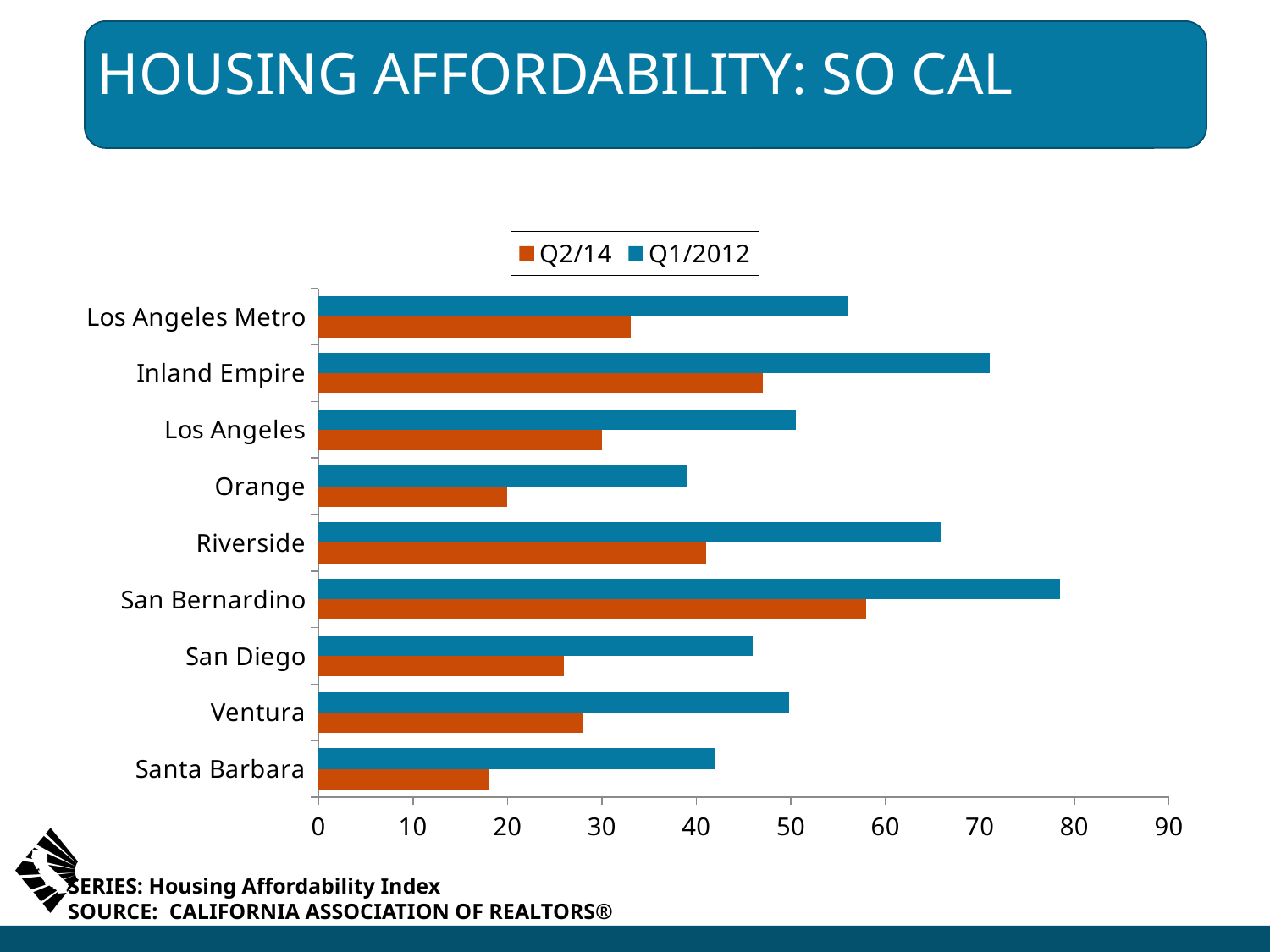
Is the Q1/2012 value for San Bernardino greater or less than 70? greater Is the Q2/14 value for Orange greater or less than 30? less Which region has the highest Q2/14 value? San Bernardino How many regions are plotted on the chart? 9 How many series does the legend list? 2 Which is larger, the Q1/2012 value for Inland Empire or the Q1/2012 value for Riverside? Inland Empire Which series is shown in orange in the legend? Q2/14 Which is larger, the Q2/14 value for Riverside or the Q2/14 value for San Diego? Riverside What kind of chart is shown on the slide? bar chart Is the Q2/14 value for Riverside greater or less than 30? greater Which region has the highest Q1/2012 value? San Bernardino